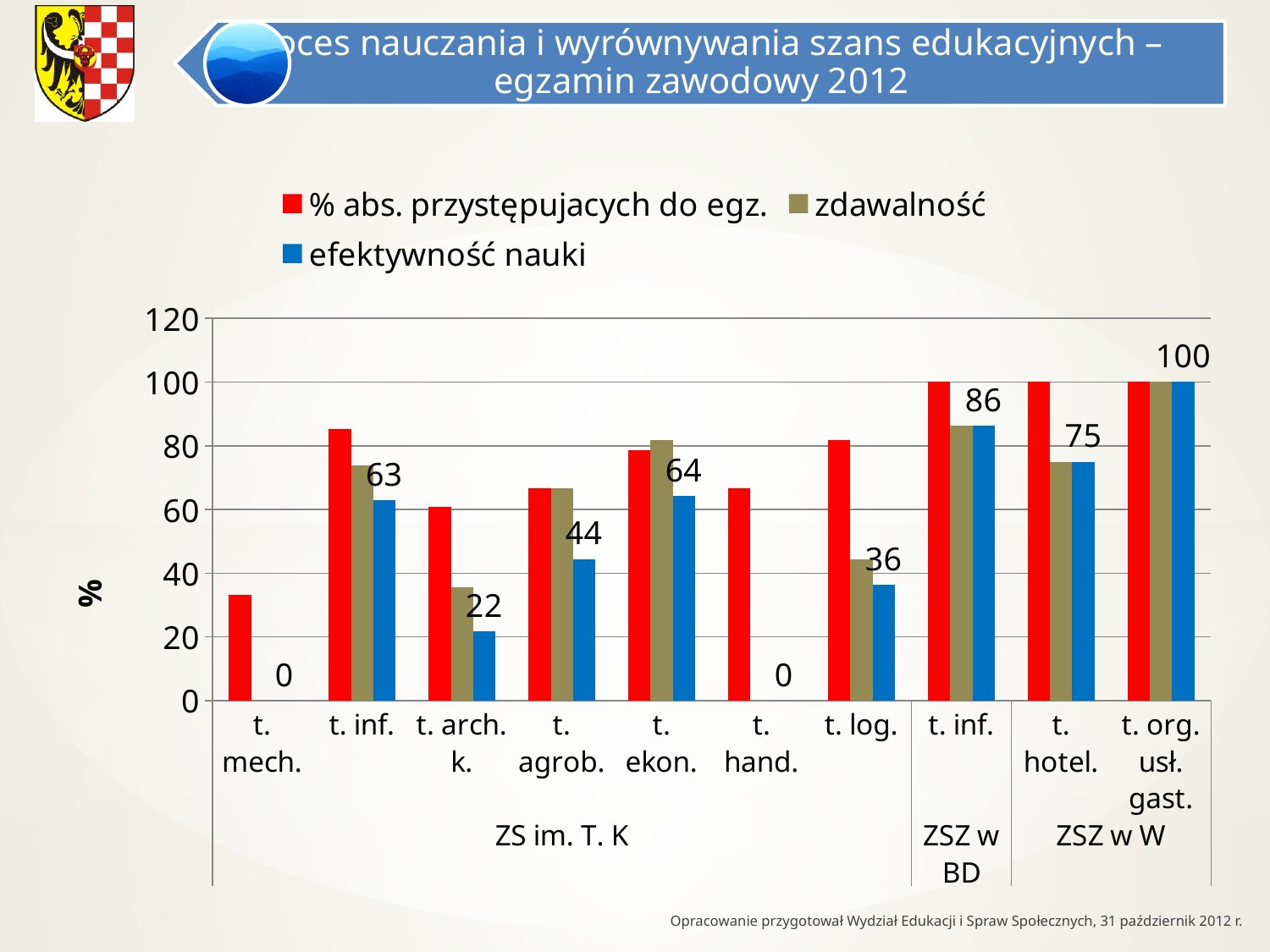
What is the efektywność nauki value for t. hotel.? 75 Which is larger, the efektywność nauki value for t. ekon. or for t. agrob.? t. ekon. Is the % abs. przystępujacych do egz. value for t. mech. greater or less than 40? less How many series does the legend list? 3 What is the efektywność nauki value for t. arch. k.? 22 Which colour represents the zdawalność series in the legend? olive/khaki What is the efektywność nauki value for t. inf. in the ZS im. T. K group? 63 Which category has the highest efektywność nauki value? t. org. usł. gast. What is the difference between the efektywność nauki values for t. inf. (ZSZ w BD) and t. log.? 50 What type of chart is shown on the slide? bar chart What is the efektywność nauki value for t. org. usł. gast.? 100 How many categories are shown along the x axis? 10